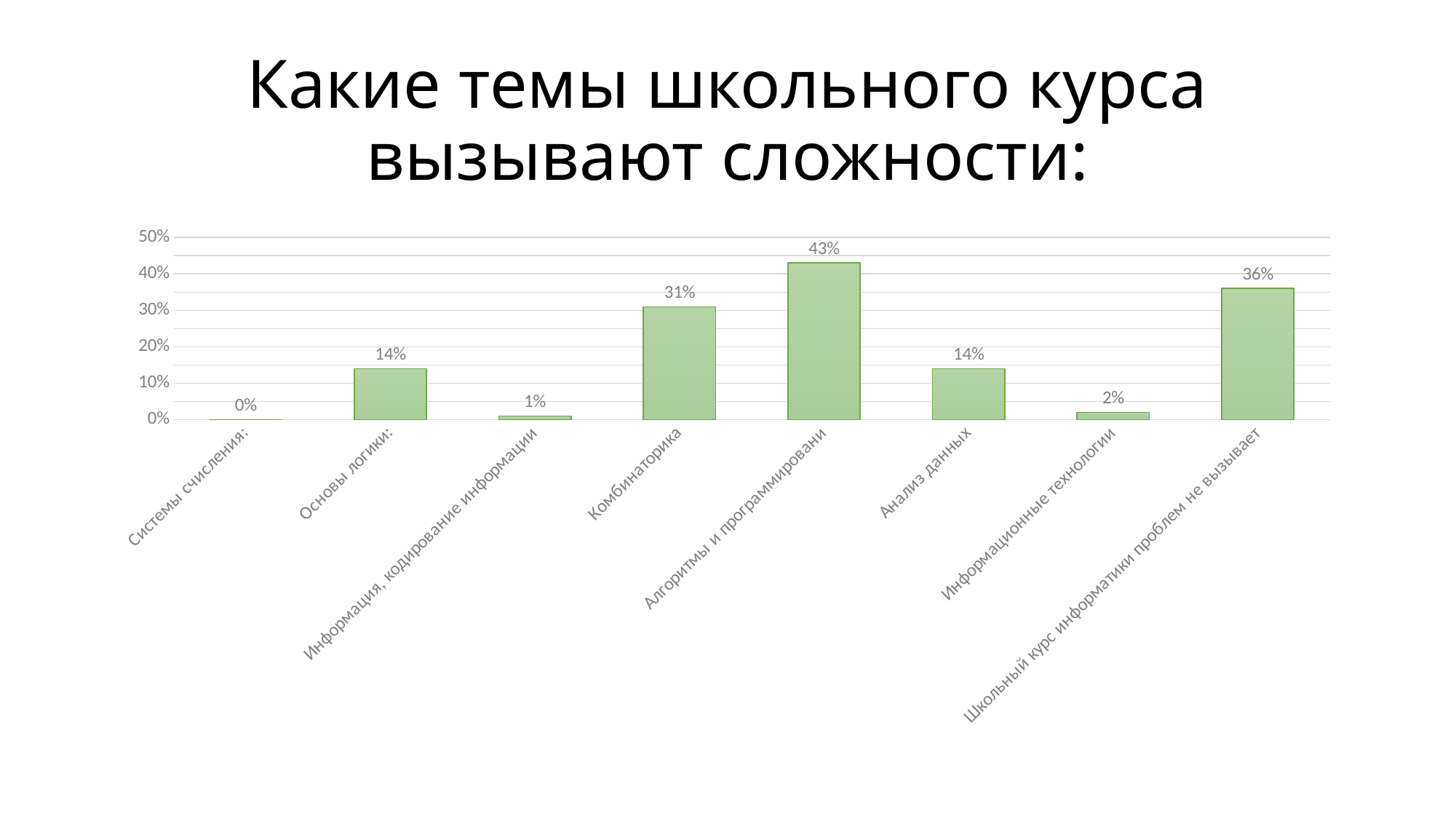
What is the title of the slide? Какие темы школьного курса вызывают сложности: What is the value for Комбинаторика? 31% What is the difference between the values for Алгоритмы и программировани and Комбинаторика? 12% Which is larger, the value for Комбинаторика or the value for Школьный курс информатики проблем не вызывает? Школьный курс информатики проблем не вызывает How many categories are shown on the chart? 8 Which category has the lowest value? Системы счисления: What is the value for Алгоритмы и программировани? 43% Is the value for Комбинаторика greater or less than 20%? greater What kind of chart is shown on the slide? bar chart What is the value for Школьный курс информатики проблем не вызывает? 36% Which category has the highest value? Алгоритмы и программировани What is the value for Информационные технологии? 2%